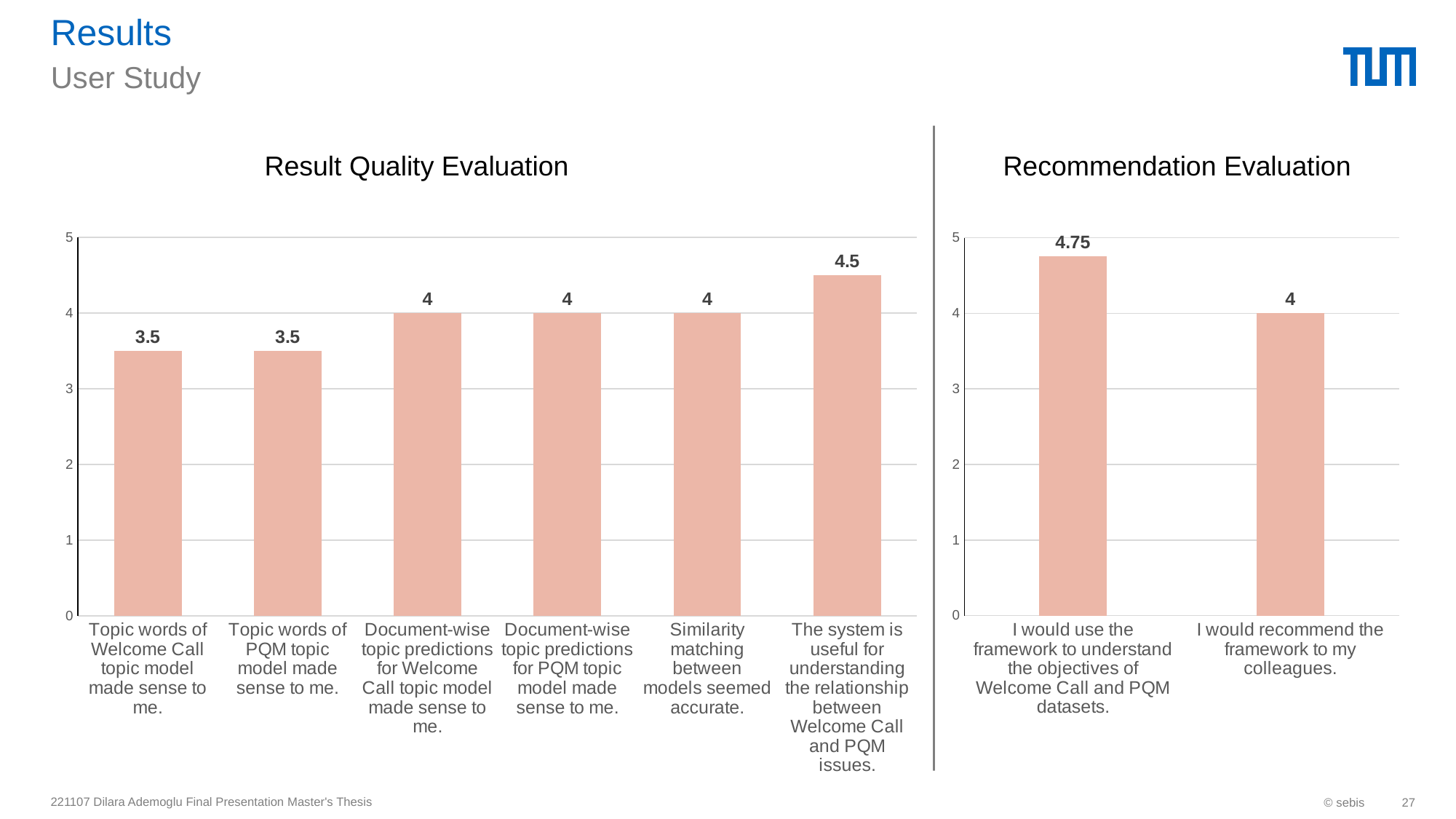
What kind of chart is the Recommendation Evaluation chart? Bar chart In the Recommendation Evaluation chart, what is the value for "I would recommend the framework to my colleagues."? 4 In the Recommendation Evaluation chart, what is the value for "I would use the framework to understand the objectives of Welcome Call and PQM datasets."? 4.75 In the Result Quality Evaluation chart, what is the value for "Topic words of Welcome Call topic model made sense to me."? 3.5 In the Result Quality Evaluation chart, how many categories are shown? 6 In the Result Quality Evaluation chart, what is the difference between the highest value and the value for "Topic words of PQM topic model made sense to me."? 1 In the Recommendation Evaluation chart, what is the difference between the two bars? 0.75 In the Result Quality Evaluation chart, which category has the highest value? The system is useful for understanding the relationship between Welcome Call and PQM issues. In the Recommendation Evaluation chart, which category has the lowest value? I would recommend the framework to my colleagues. In the Result Quality Evaluation chart, what is the value for "Similarity matching between models seemed accurate."? 4 What is the title of the chart on the left side of the slide? Result Quality Evaluation In the Result Quality Evaluation chart, is the value for "Topic words of PQM topic model made sense to me." greater or less than 3? greater